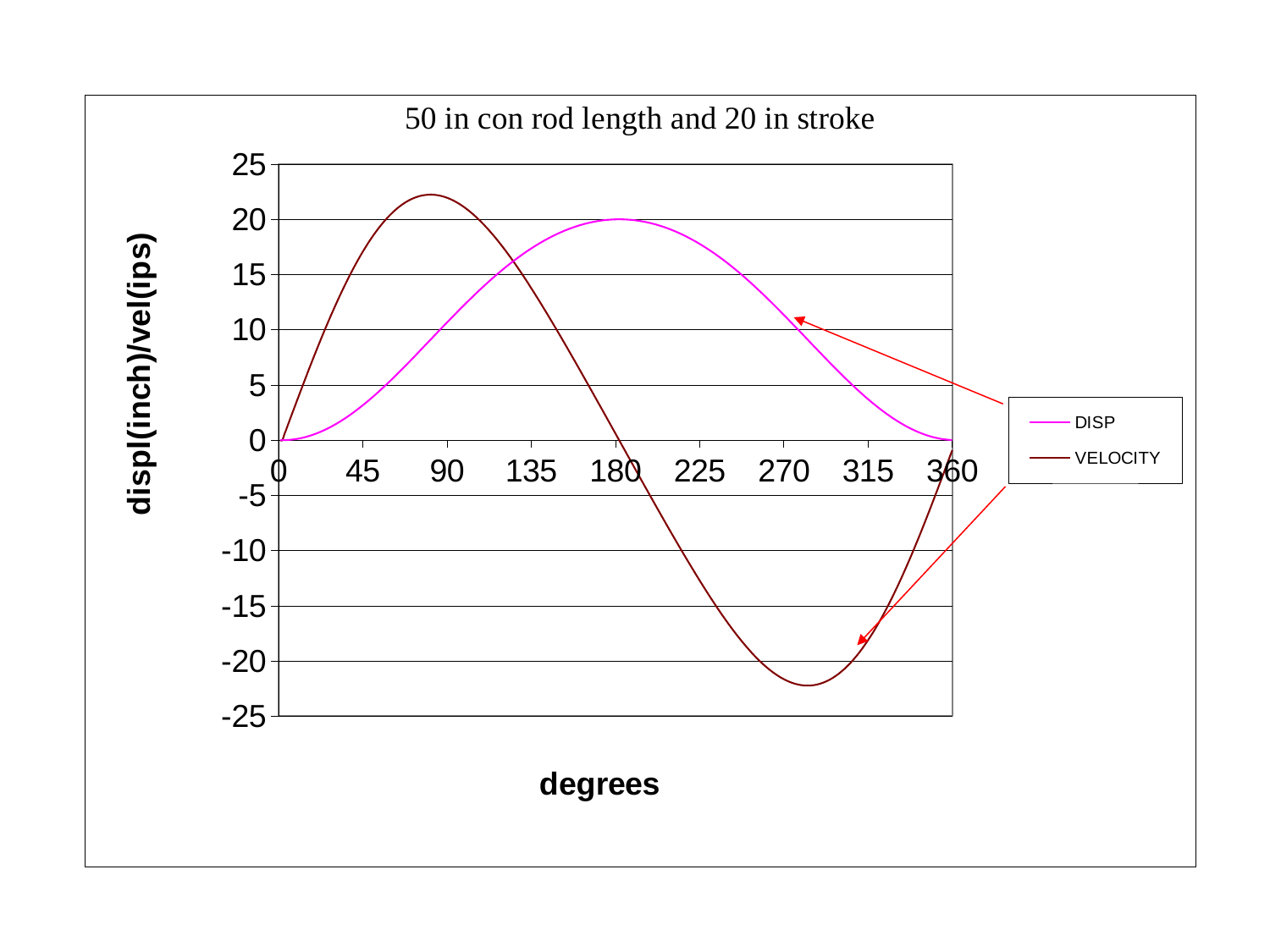
What is the value of DISP at 180 degrees? 20 Which series reaches the higher peak value, DISP or VELOCITY? VELOCITY How many series does the legend list? 2 What is the value of VELOCITY at 180 degrees? 0 What is the title of the chart? 50 in con rod length and 20 in stroke What kind of chart is shown on the slide? line chart Does the DISP line rise or fall between 180 and 360 degrees? fall At 45 degrees, which series has the larger value, DISP or VELOCITY? VELOCITY What is the label on the x axis of the chart? degrees Is the value of VELOCITY at 270 degrees greater or less than -20? less Is the value of VELOCITY at 90 degrees greater or less than 20? greater What is the value of DISP at 0 degrees? 0